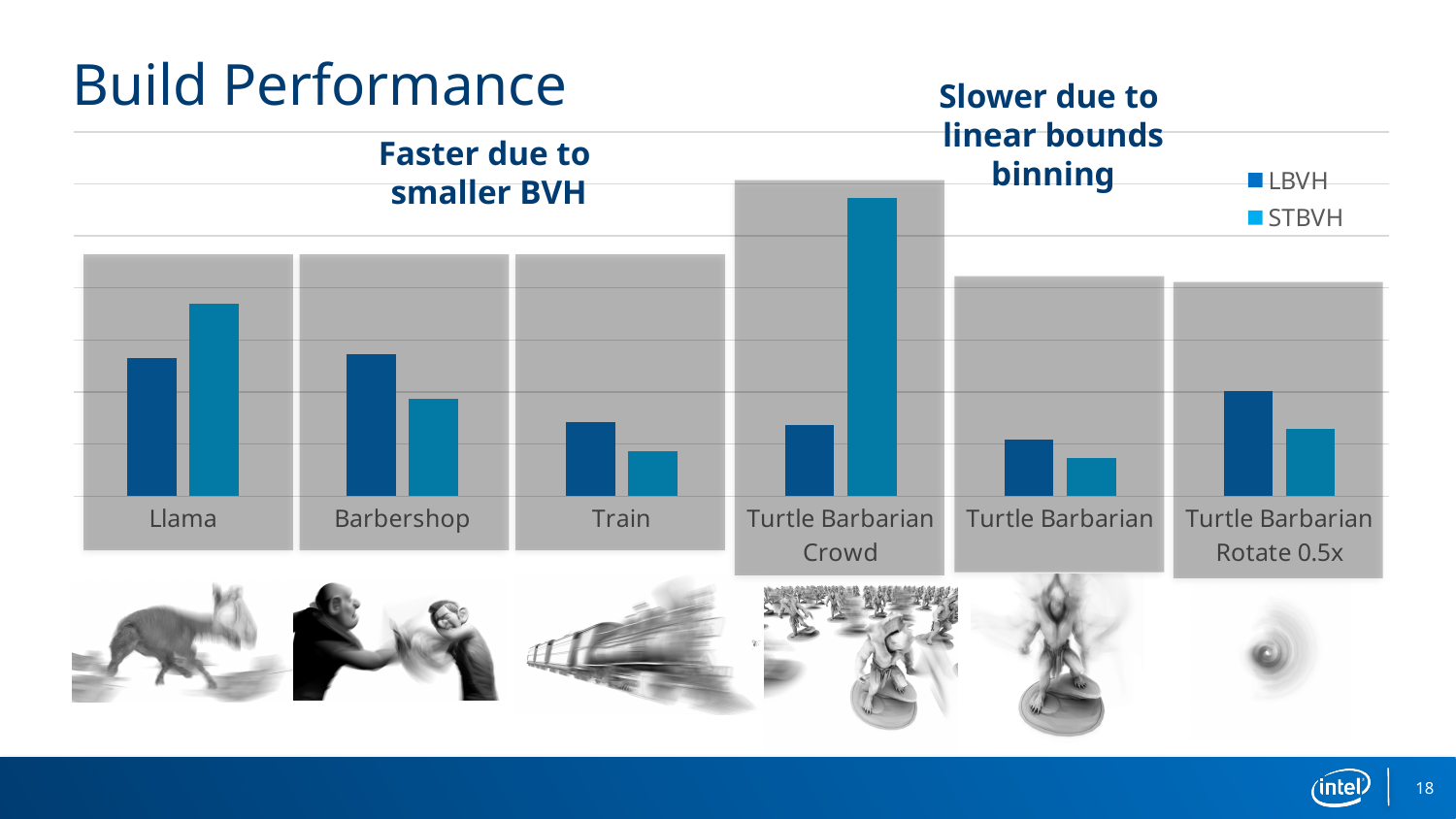
What is the title of the slide containing the chart? Build Performance Which category has the highest STBVH bar? Turtle Barbarian Crowd What kind of chart is shown on the slide? bar chart For Llama, which series has the larger bar, LBVH or STBVH? STBVH For Train, which series has the larger bar, LBVH or STBVH? LBVH For Turtle Barbarian Crowd, which series has the larger bar, LBVH or STBVH? STBVH What are the two series names listed in the chart legend? LBVH and STBVH How many categories are shown along the x axis? 6 Which category has the lowest LBVH bar? Turtle Barbarian How many series does the legend list? 2